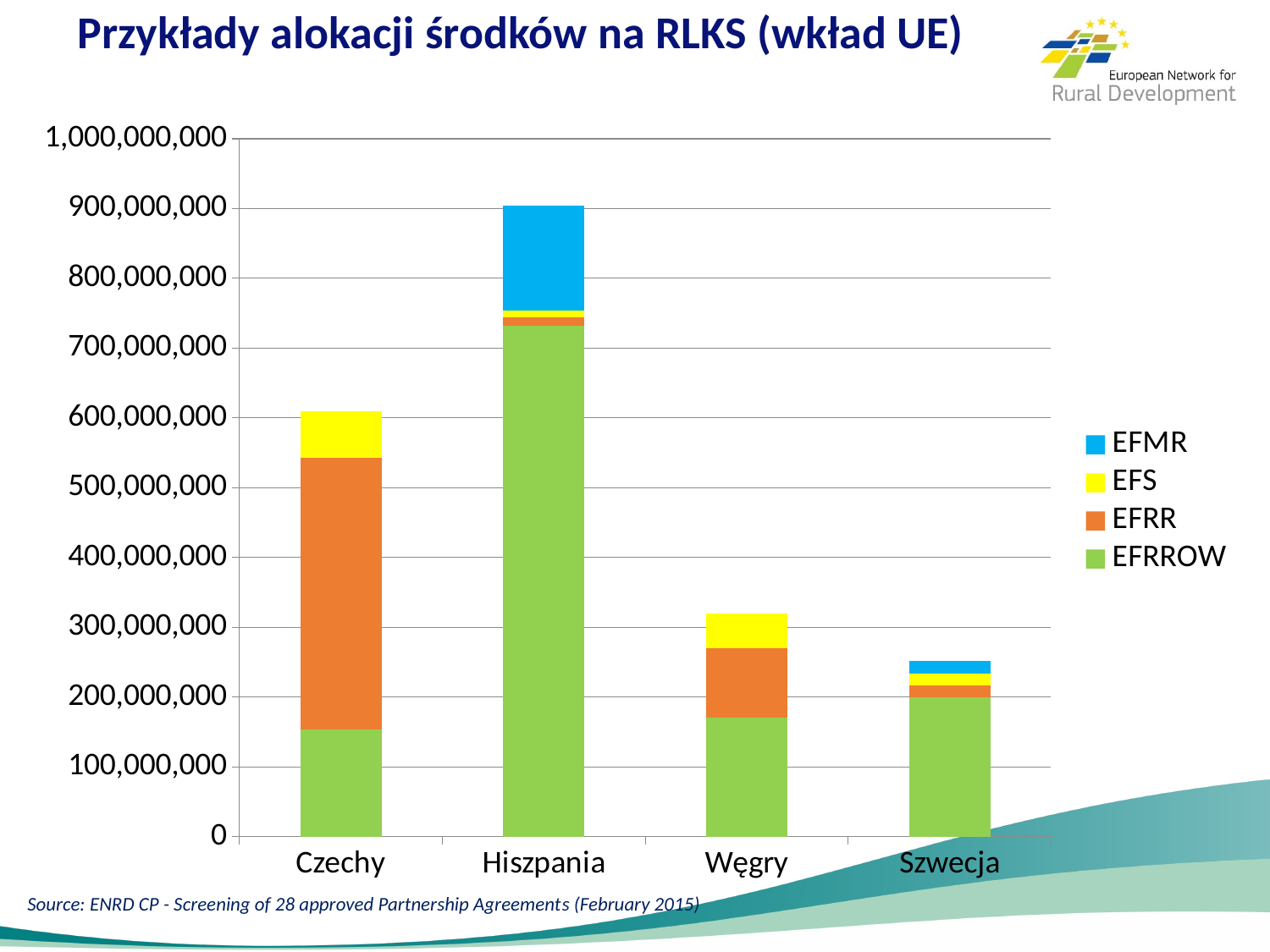
Which country has the largest EFRR (orange) segment? Czechy How many countries are shown on the x axis of the chart? 4 Which country has the lowest total bar? Szwecja Is the total bar for Czechy greater or less than 500,000,000? greater Is the total bar for Hiszpania greater or less than 800,000,000? greater What kind of chart is shown on the slide? Stacked bar chart Which series appears at the bottom of each stacked bar? EFRROW Which has a larger total bar, Czechy or Węgry? Czechy Which country has the highest total bar? Hiszpania Is the total bar for Szwecja greater or less than 300,000,000? less How many series does the legend list? 4